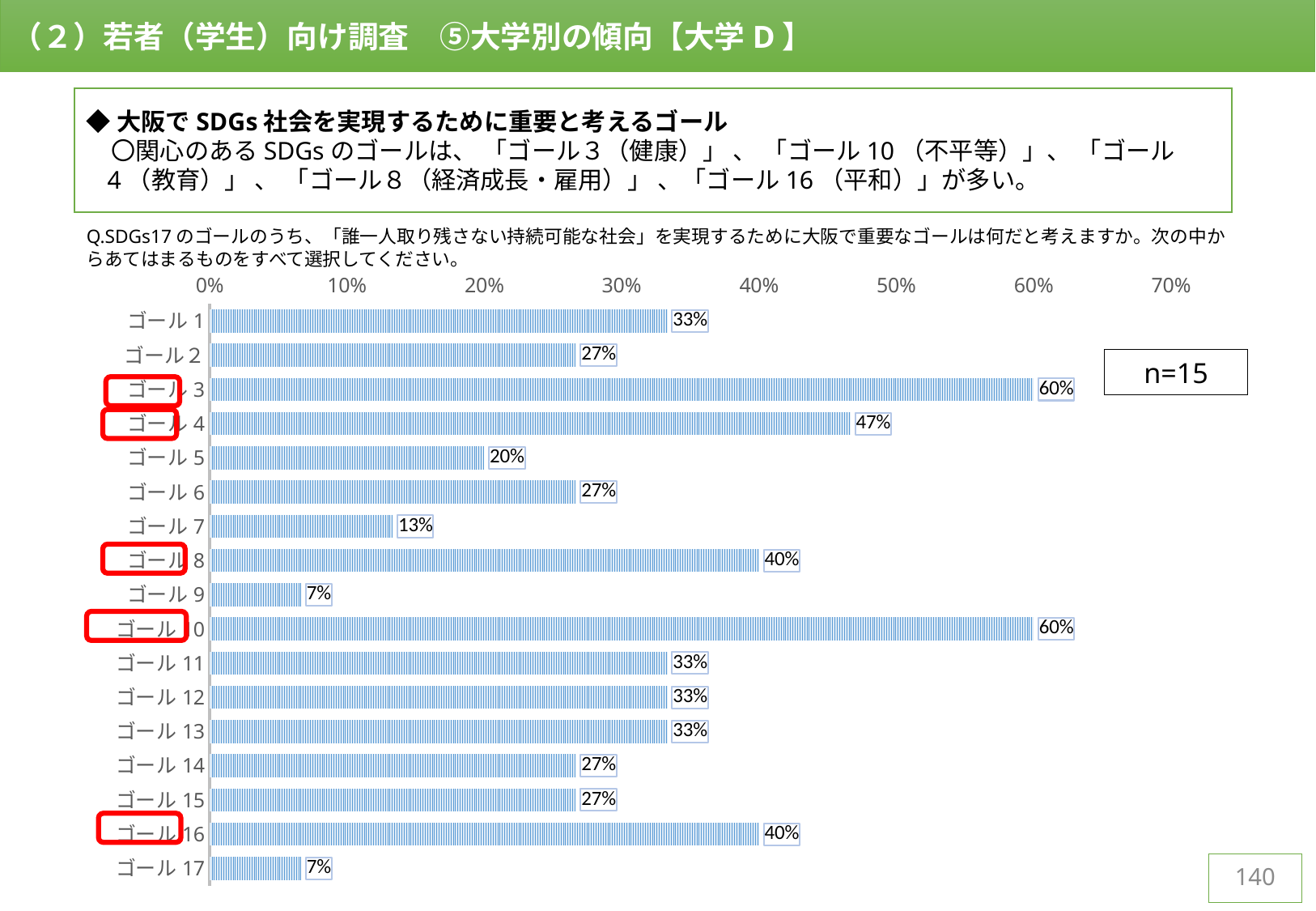
What is the value for ゴール7? 13% What is the difference between the values for ゴール4 and ゴール5? 27% What is the value for ゴール4? 47% What is the value for ゴール3? 60% What sample size (n) is shown on the slide? n=15 Is the value for ゴール10 greater or less than 50%? greater How many goal categories are plotted in the chart? 17 What is the highest value shown in the chart? 60% What is the value for ゴール16? 40% What kind of chart is shown on the slide? bar chart Which has a larger value, ゴール8 or ゴール7? ゴール8 What is the lowest value shown in the chart? 7%